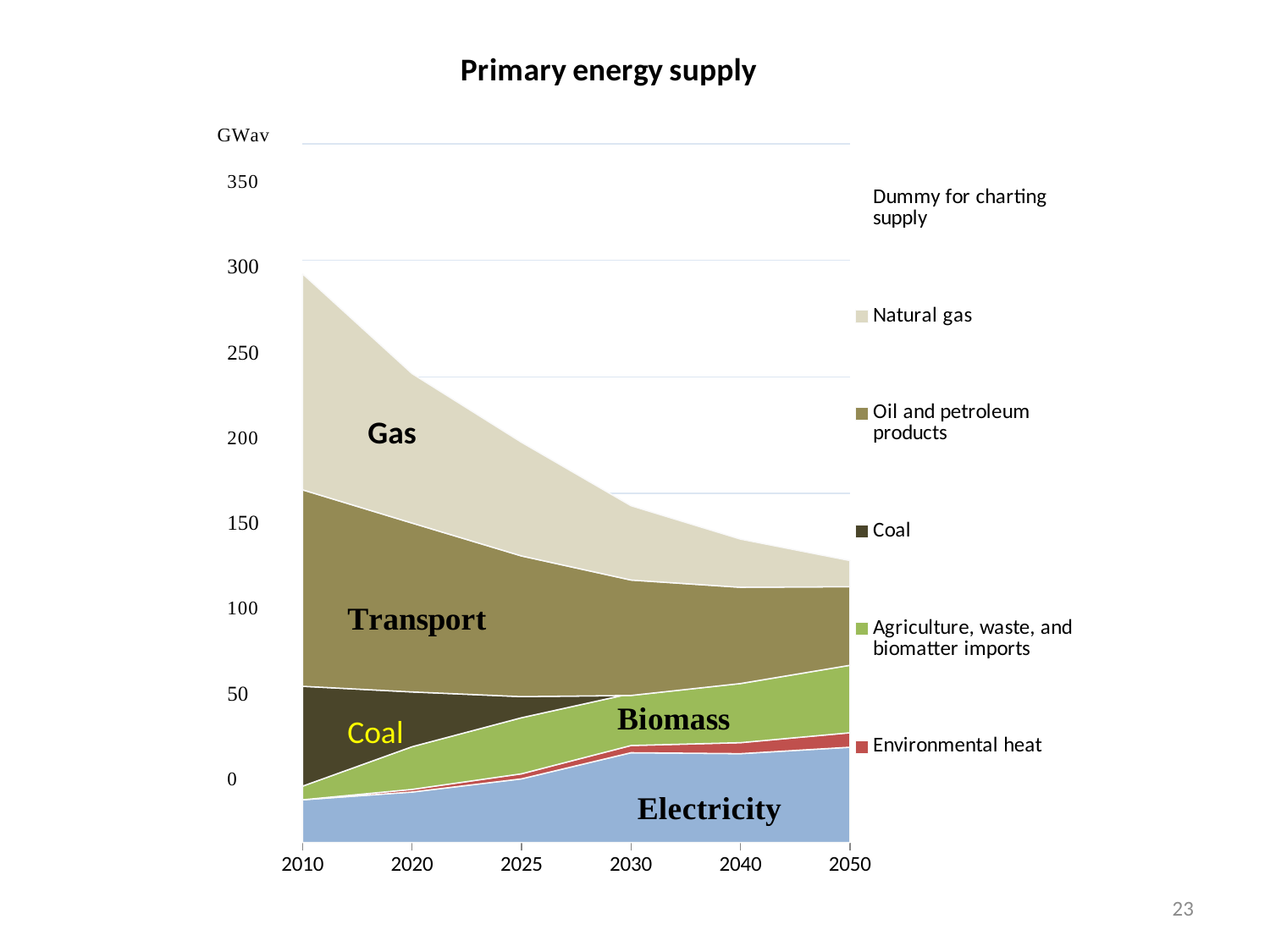
Is the total primary energy supply in 2050 greater or less than 100? greater What unit is shown on the vertical axis of the chart? GWav Does the Coal area grow or shrink between 2010 and 2030? Shrink Is the total primary energy supply in 2020 greater or less than 200? greater What is the title of the chart? Primary energy supply How many entries does the chart's legend list? 6 How many years are labelled on the x axis of the chart? 6 Does the total primary energy supply rise or fall from 2010 to 2050? Fall Which year has the larger total primary energy supply, 2010 or 2050? 2010 What kind of chart is shown on the slide? Stacked area chart Is the total primary energy supply in 2020 greater or less than 250? less